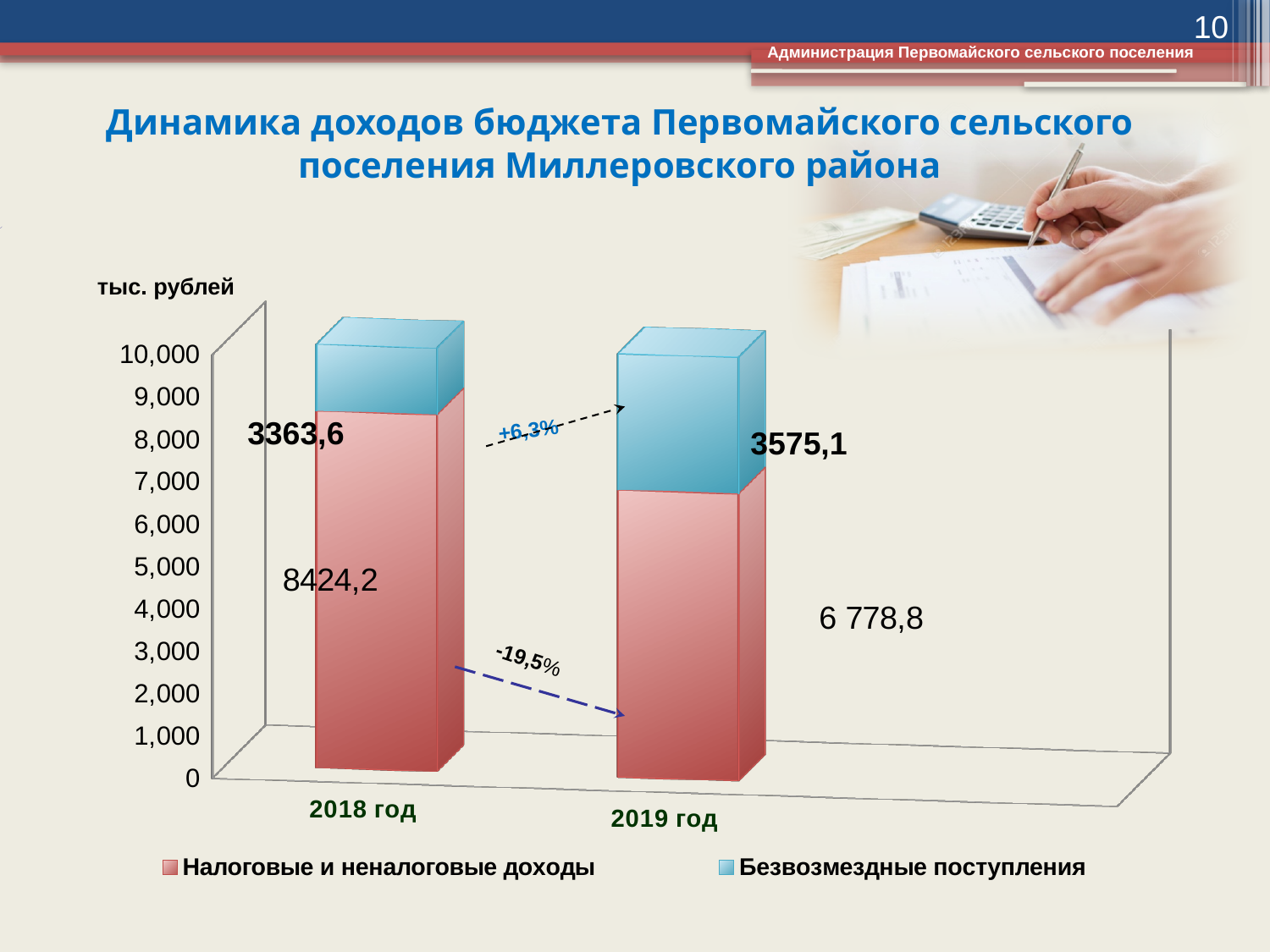
What kind of chart is shown on the slide? Stacked bar chart By how much did Безвозмездные поступления increase from 2018 год to 2019 год? 211,5 What is the value of Налоговые и неналоговые доходы for 2018 год? 8424,2 What percentage change is shown for Безвозмездные поступления between 2018 год and 2019 год? +6,3% By how much did Налоговые и неналоговые доходы decrease from 2018 год to 2019 год? 1645,4 What is the value of Безвозмездные поступления for 2019 год? 3575,1 What is the value of Безвозмездные поступления for 2018 год? 3363,6 What is the total of the stacked bar for 2018 год? 11787,8 What is the total of the stacked bar for 2019 год? 10353,9 How many series does the legend list? 2 What is the value of Налоговые и неналоговые доходы for 2019 год? 6 778,8 Which year has the higher value for Налоговые и неналоговые доходы? 2018 год